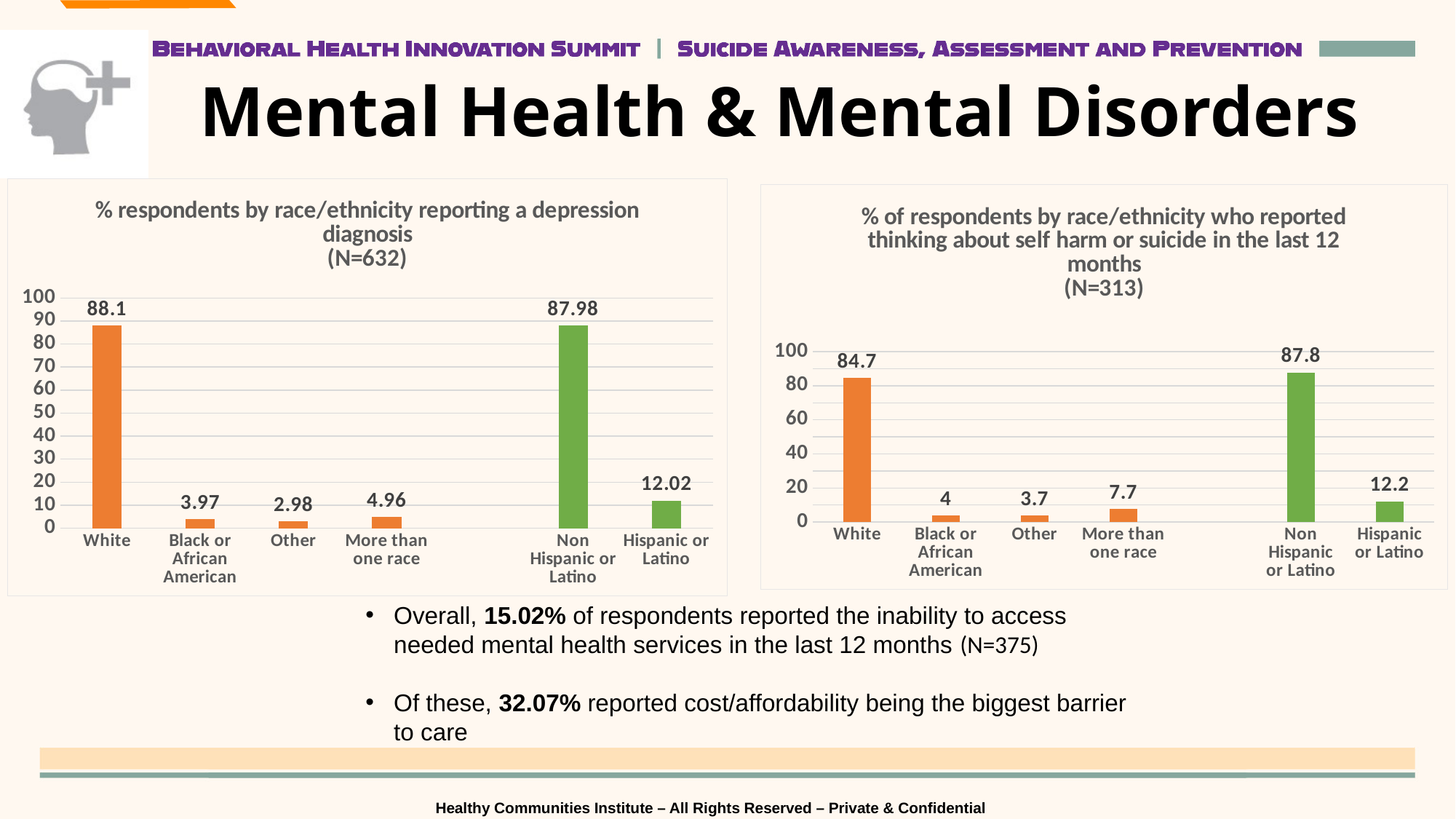
In the left chart (depression diagnosis), what is the value for Hispanic or Latino? 12.02 In the left chart (depression diagnosis), which category has the lowest value? Other What sample size (N) is given in the title of the left chart (depression diagnosis)? N=632 In the right chart (thinking about self harm or suicide), what is the value for Non Hispanic or Latino? 87.8 What kind of chart is the right chart (thinking about self harm or suicide)? Bar chart In the left chart (depression diagnosis), what is the difference between the values for White and Non Hispanic or Latino? 0.12 In the right chart (thinking about self harm or suicide), what is the value for More than one race? 7.7 In the right chart (thinking about self harm or suicide), what is the difference between the values for Hispanic or Latino and More than one race? 4.5 In the right chart (thinking about self harm or suicide), which is larger: the value for Black or African American or the value for Other? Black or African American In the left chart (depression diagnosis), how many categories are shown on the x axis? 6 In the right chart (thinking about self harm or suicide), which category has the highest value? Non Hispanic or Latino In the left chart (% respondents by race/ethnicity reporting a depression diagnosis), what is the value for White? 88.1